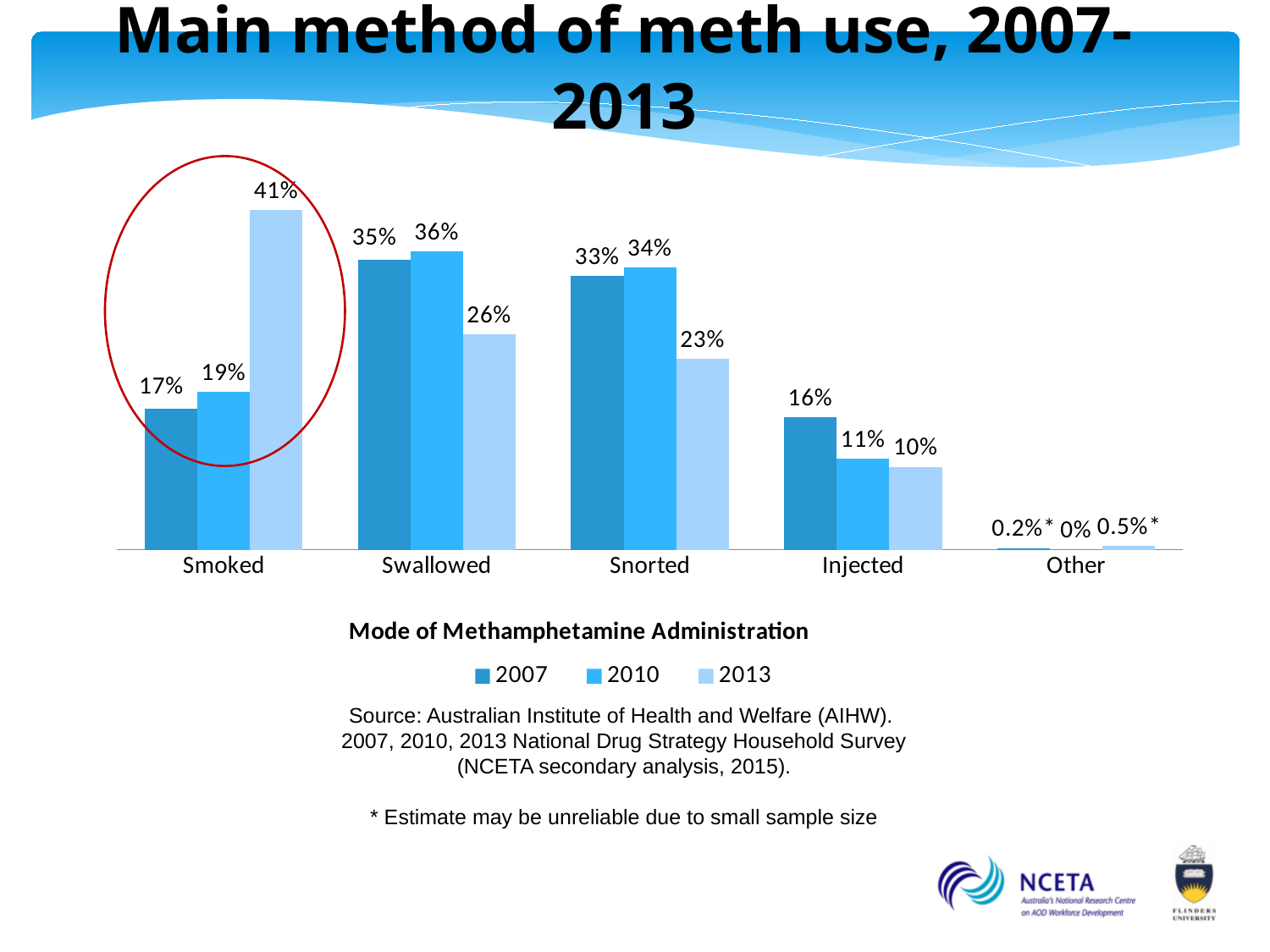
By how many percentage points did Smoked increase from 2007 to 2013? 24 percentage points How many modes of administration are shown on the x axis? 5 What was the value for Swallowed in 2007? 35% In 2013, which was larger: Swallowed or Snorted? Swallowed How many series does the legend list? 3 Which mode of administration had the lowest value in 2007? Other What percentage of meth users reported smoking as their main method in 2013? 41% Which mode of administration had the highest value in 2013? Smoked What kind of chart is shown on the slide? Bar chart What was the value for Injected in 2010? 11% What is the difference between the 2010 and 2013 values for Snorted? 11 percentage points Did the value for Injected rise or fall from 2007 to 2013? Fall